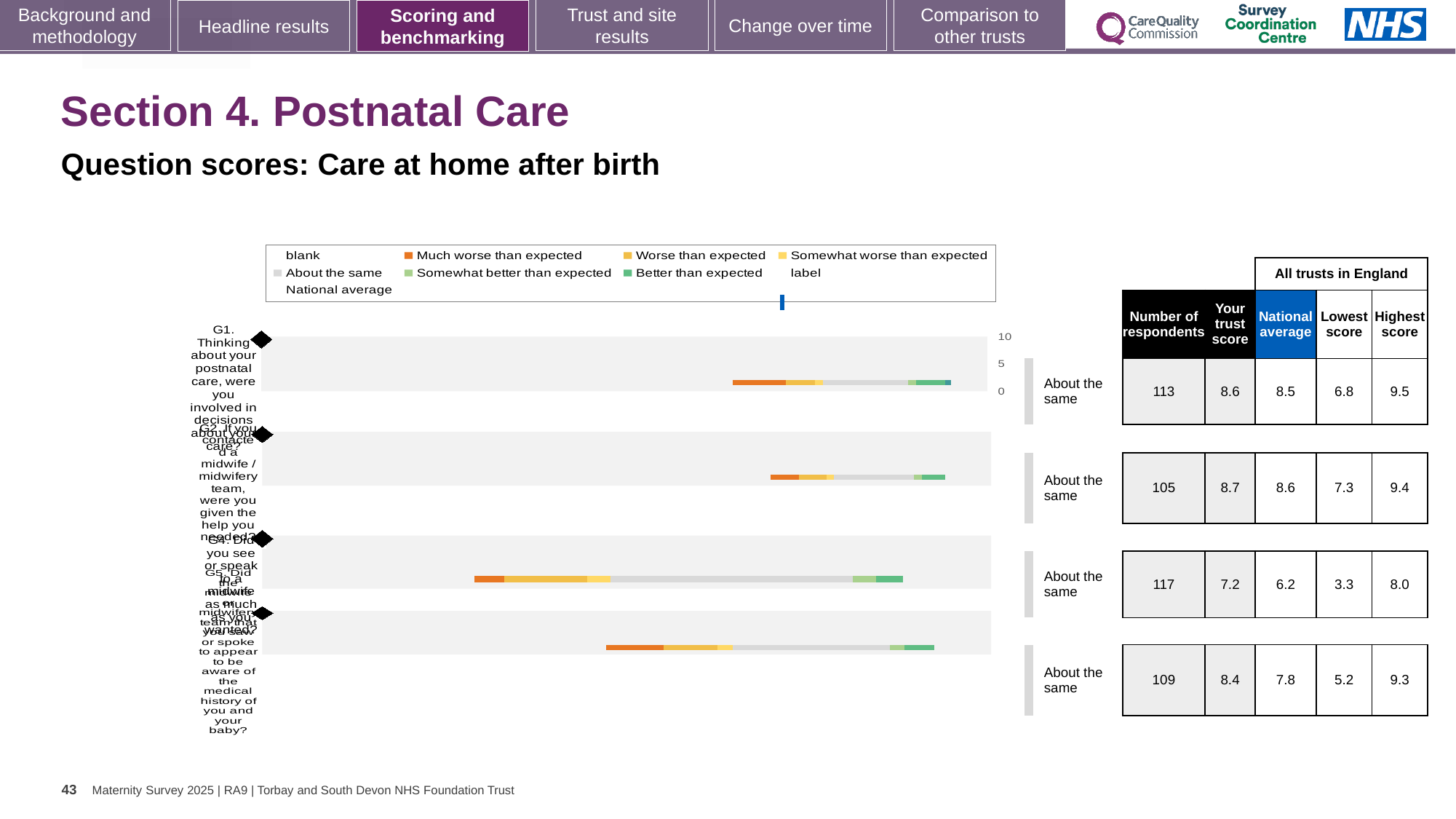
What colour represents 'Much worse than expected' in the legend? orange For the third row, what is the difference between 'Your trust score' and the 'National average'? 1.0 What is the first entry in the chart legend? blank How many question bars are plotted in the chart? 4 For the first row, which is larger: 'Your trust score' or the 'National average'? Your trust score What kind of chart is shown on the slide? bar chart What is the lowest 'National average' value shown in the table? 6.2 How many entries does the chart legend list? 9 Which row has the highest 'Your trust score' in the table? the second row (8.7) What is the 'Highest score' for the fourth row of the table? 9.3 What is 'Your trust score' for the third row of the table? 7.2 What is the number of respondents for the first row (G1, involved in decisions about your care)? 113